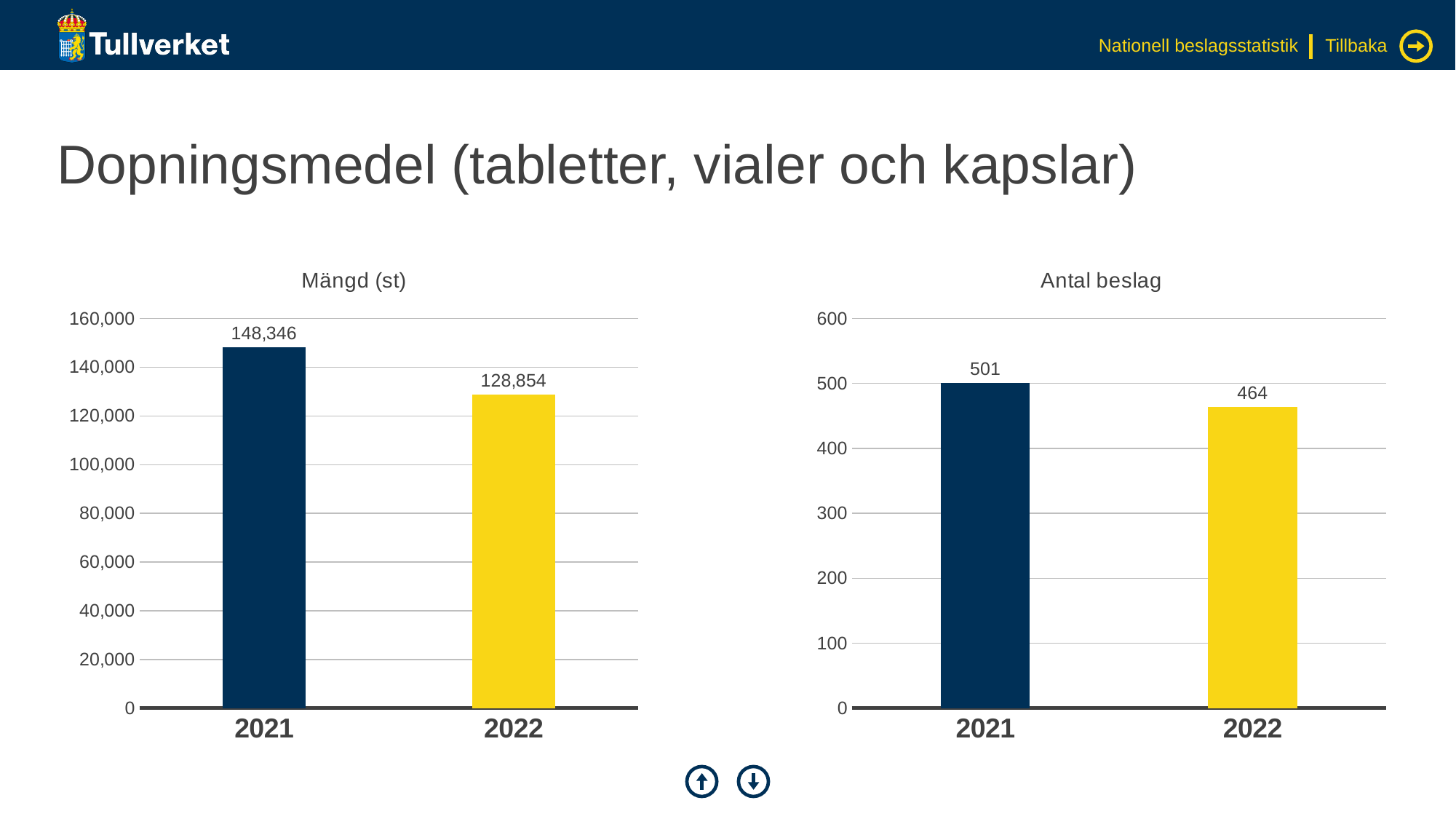
In the 'Mängd (st)' chart, what is the value for 2021? 148,346 In the 'Mängd (st)' chart, do the values rise or fall from 2021 to 2022? fall How many years are shown in the 'Mängd (st)' chart? 2 In the 'Antal beslag' chart, what is the value for 2021? 501 In the 'Mängd (st)' chart, what is the value for 2022? 128,854 In the 'Antal beslag' chart, what is the value for 2022? 464 In the 'Antal beslag' chart, which year has the lowest value? 2022 In the 'Antal beslag' chart, what is the difference between the 2021 and 2022 values? 37 In the 'Antal beslag' chart, is the value for 2022 greater or less than 500? less In the 'Mängd (st)' chart, what is the difference between the 2021 and 2022 values? 19,492 In the 'Mängd (st)' chart, which year has the highest value? 2021 What kind of chart is the 'Antal beslag' chart? bar chart